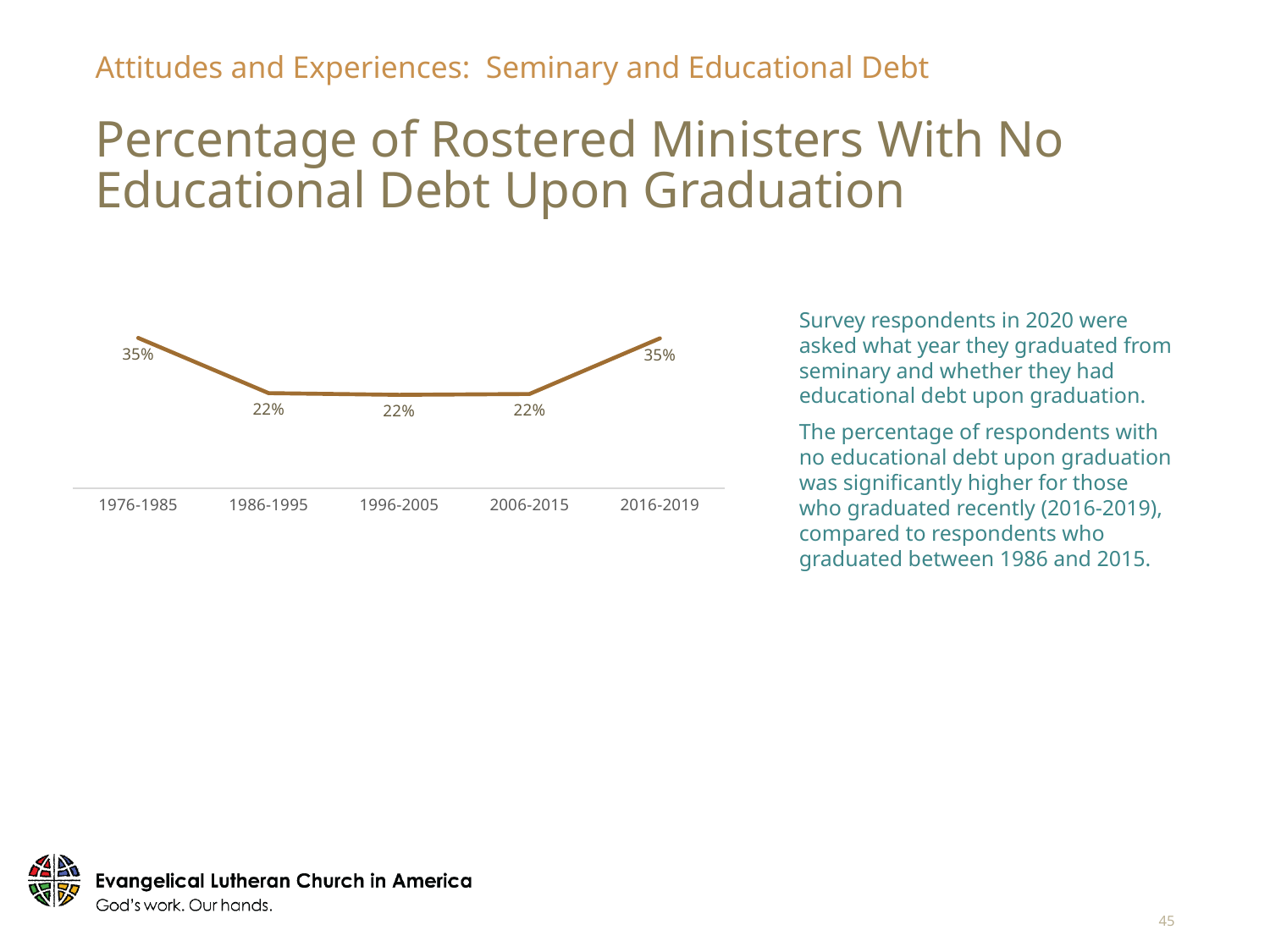
What is the value shown for the 1996-2005 graduation period? 22% What is the value shown for the 2016-2019 graduation period? 35% What is the highest value plotted on the chart? 35% What percentage of rostered ministers who graduated in 1976-1985 had no educational debt upon graduation? 35% What kind of chart is shown on the slide? Line chart What is the title of the chart on the slide? Percentage of Rostered Ministers With No Educational Debt Upon Graduation Does the value rise or fall from 2006-2015 to 2016-2019? Rise Which has a higher value, 1976-1985 or 1986-1995? 1976-1985 What is the lowest value plotted on the chart? 22% How many graduation periods are shown on the x axis? 5 What is the difference between the value for 2016-2019 and the value for 2006-2015? 13% What is the value shown for the 2006-2015 graduation period? 22%